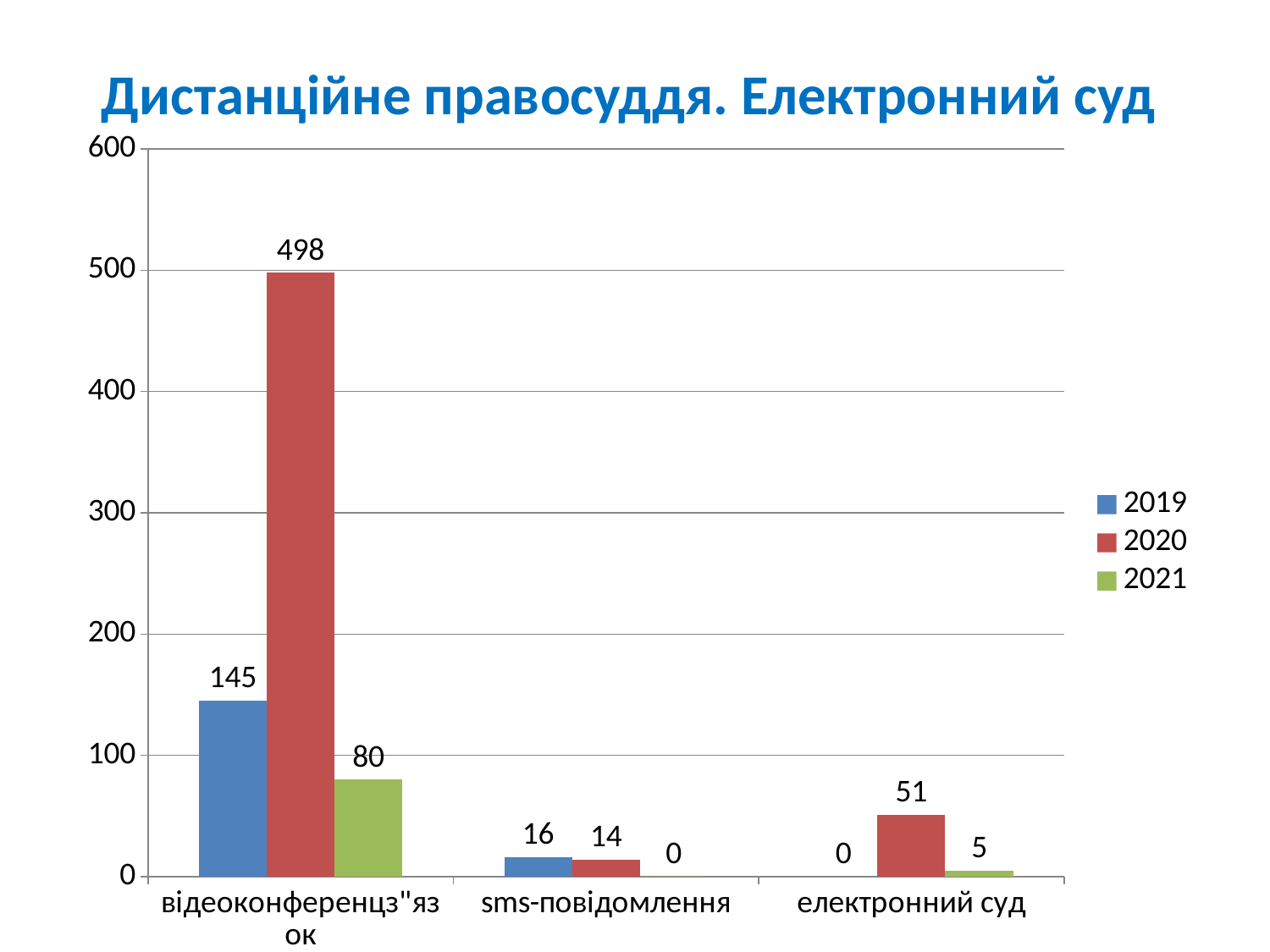
What is the title of the chart? Дистанційне правосуддя. Електронний суд Which year has the lowest value in the електронний суд category? 2019 How many series does the legend list? 3 What kind of chart is shown on the slide? bar chart How many categories are shown on the x axis? 3 What is the value for 2019 in the sms-повідомлення category? 16 Is the value for 2019 in the відеоконференцз"язок category greater or less than 100? greater What is the value for 2021 in the електронний суд category? 5 Which year has the highest value in the відеоконференцз"язок category? 2020 What is the value for 2020 in the відеоконференцз"язок category? 498 Which is larger: the 2019 value or the 2020 value for sms-повідомлення? 2019 What is the difference between the 2020 and 2019 values in the відеоконференцз"язок category? 353